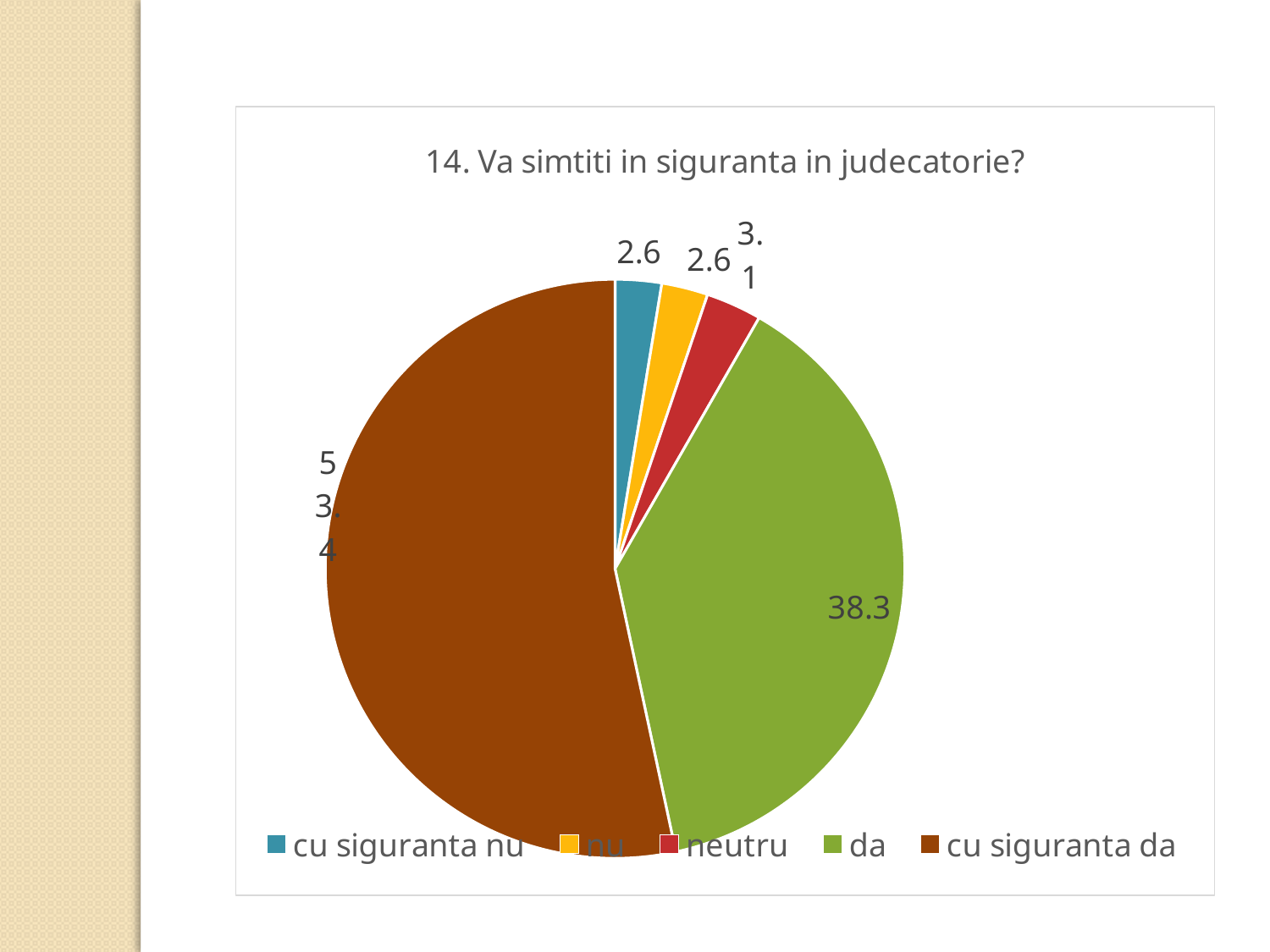
What type of chart is shown on the slide? pie chart Which is larger, the value for "neutru" or the value for "nu"? neutru What is the difference between the values for "cu siguranta da" and "da"? 15.1 What is the title of the chart? 14. Va simtiti in siguranta in judecatorie? How many slices does the pie chart have? 5 What is the value for "da"? 38.3 Which category has the largest slice? cu siguranta da What is the difference between the values for "da" and "neutru"? 35.2 What is the value for "cu siguranta nu"? 2.6 What colour is the slice for "da"? green What is the value for "neutru"? 3.1 What is the value for "cu siguranta da"? 53.4